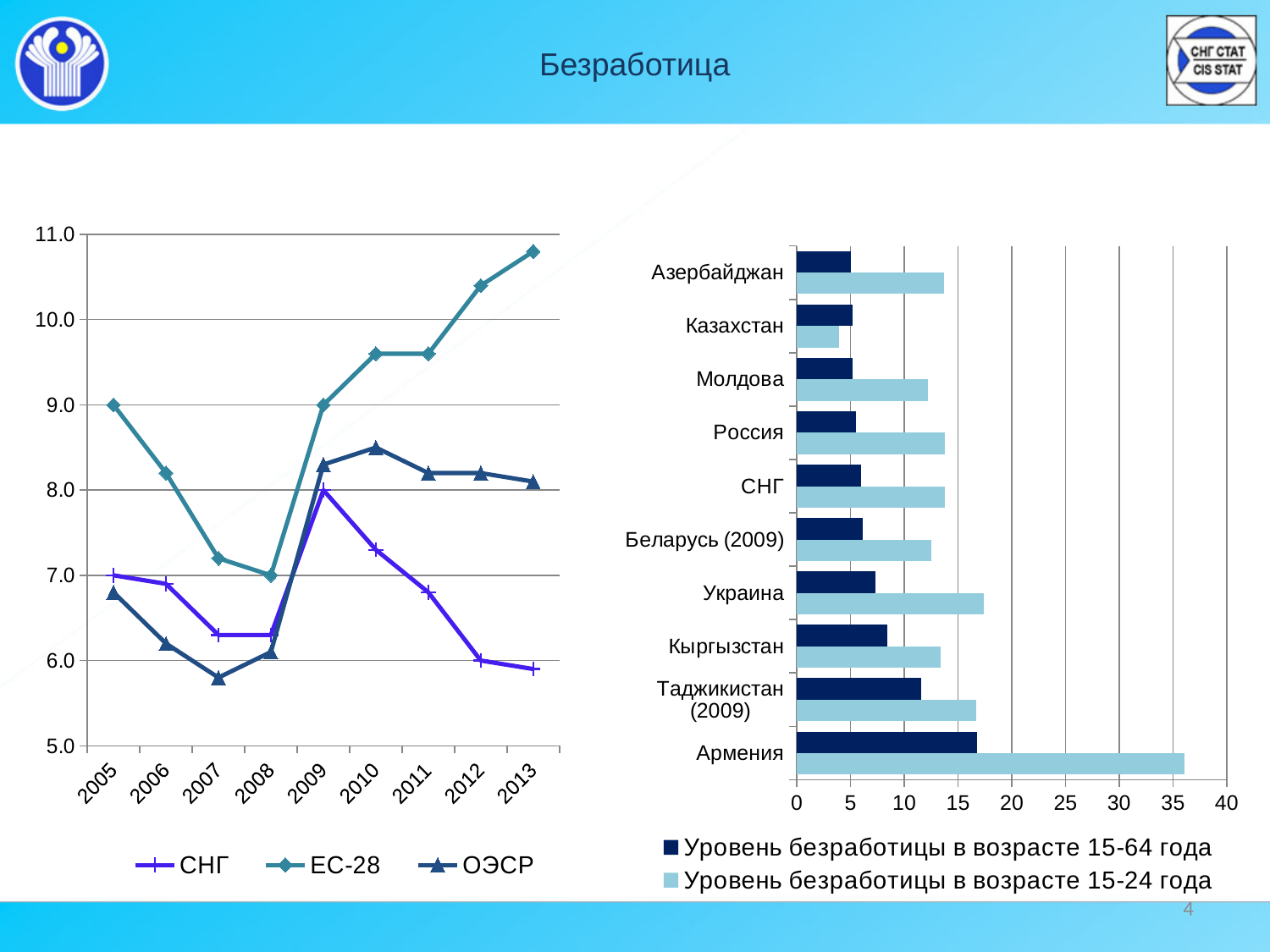
What kind of chart is the chart on the right side of the slide? bar chart In the line chart on the left, does the ЕС-28 series rise or fall from 2009 to 2013? rise In the line chart on the left, what is the value for ЕС-28 in 2005? 9.0 In the line chart on the left, in which year is the ЕС-28 series at its lowest? 2008 In the bar chart on the right, how many series does the legend list? 2 In the bar chart on the right, how many countries/regions are listed on the vertical axis? 10 What kind of chart is the chart on the left side of the slide? line chart In the line chart on the left, how many years are shown on the x axis? 9 In the bar chart on the right, which country has the highest value for Уровень безработицы в возрасте 15-24 года? Армения In the line chart on the left, how many series does the legend list? 3 In the line chart on the left, what is the value for СНГ in 2009? 8.0 In the bar chart on the right, is the value for Армения for Уровень безработицы в возрасте 15-24 года greater or less than 35? greater